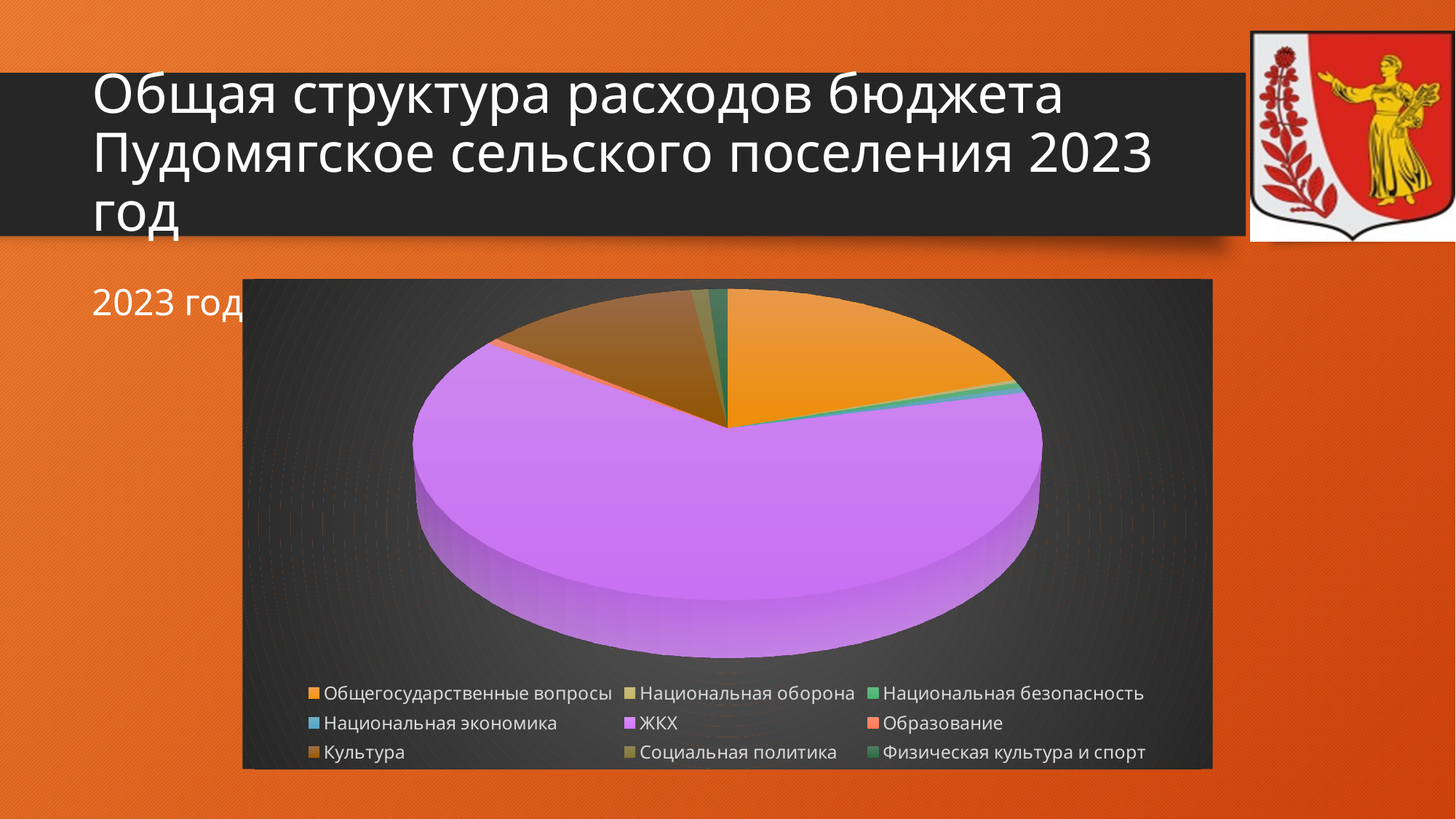
Is the ЖКХ slice larger or smaller than all the other slices combined? larger What kind of chart is shown on the slide? pie chart How many categories does the legend of the pie chart list? 9 Which slice is larger: Культура or Физическая культура и спорт? Культура Which slice is larger: ЖКХ or Культура? ЖКХ Which category has the largest slice of the pie chart? ЖКХ What is the title of the slide containing the pie chart? Общая структура расходов бюджета Пудомягское сельского поселения 2023 год What colour is the ЖКХ slice in the pie chart? purple